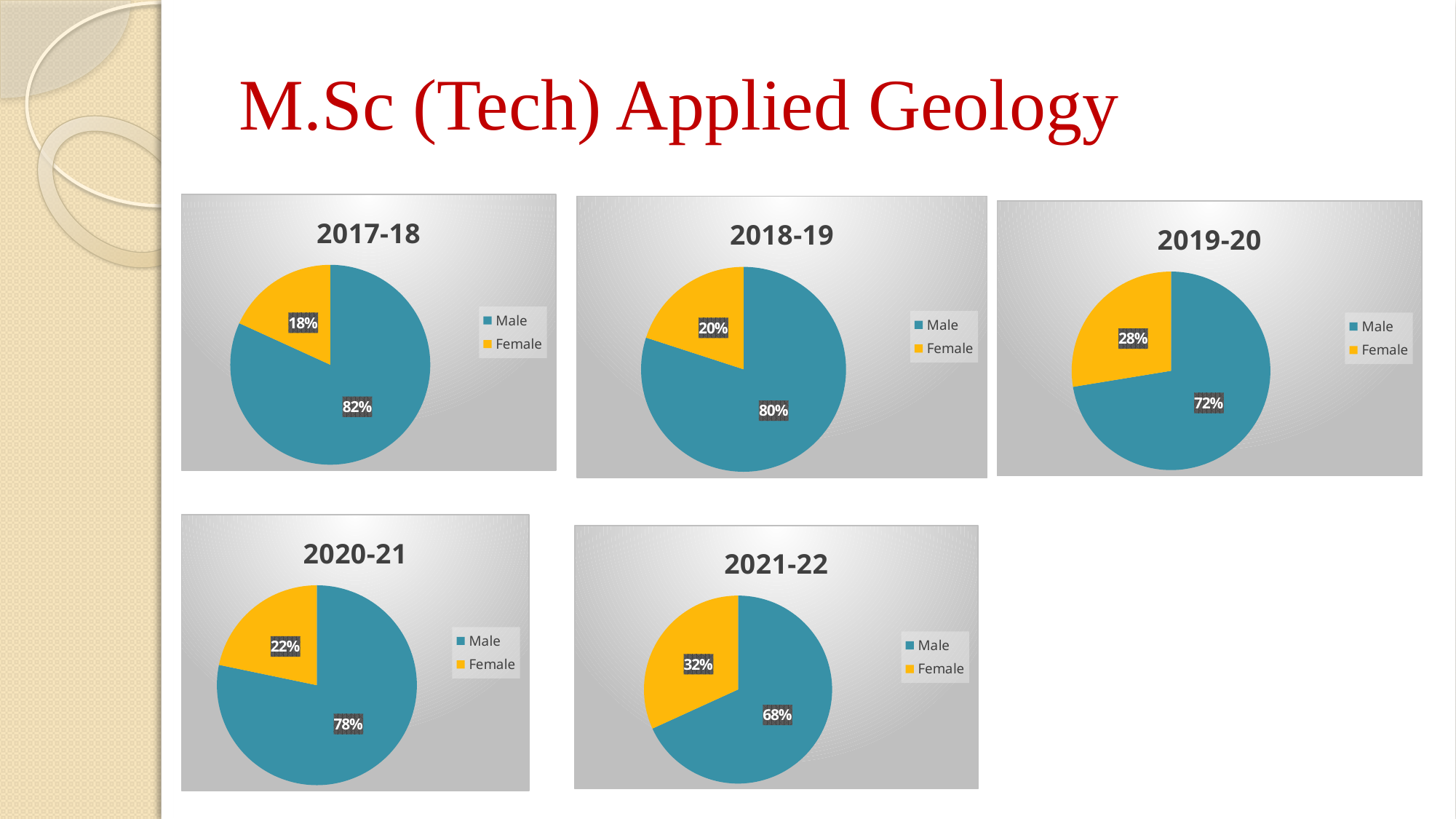
How many charts are on the slide? 5 In the 2017-18 chart, which category has the smaller share? Female What type of chart is the 2020-21 chart? Pie chart How many entries does the legend of the 2018-19 chart list? 2 In the 2021-22 chart, what percentage is Female? 32% Is the Female share larger in the 2018-19 chart or the 2020-21 chart? 2020-21 In the 2019-20 chart, what percentage is Female? 28% In the 2017-18 chart, what percentage is Female? 18% In the 2021-22 chart, which category has the larger share? Male In the 2019-20 chart, what is the difference between the Male and Female percentages? 44% In the 2020-21 chart, what percentage is Male? 78% In the 2018-19 chart, what percentage is Male? 80%